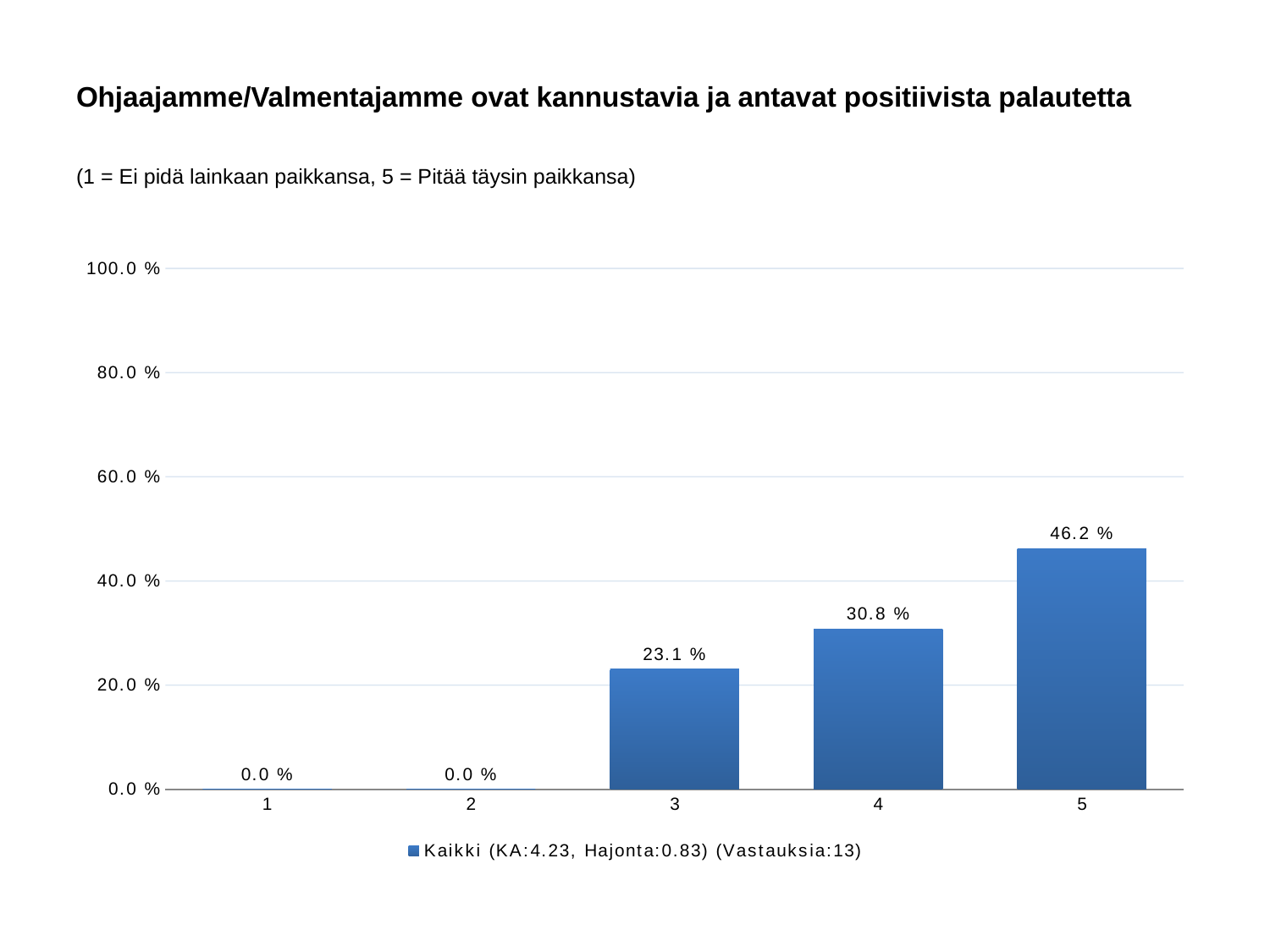
How many series does the legend list? 1 What is the difference between the values for category 5 and category 4? 15.4 % What is the value for category 4? 30.8 % What kind of chart is shown? bar chart What is the value for category 3? 23.1 % Do the values rise or fall from category 1 to category 5? rise Which category has the highest value? 5 Which is larger, the value for category 3 or category 4? 4 Is the value for category 5 greater or less than 40.0 %? greater What is the value for category 1? 0.0 % How many categories are shown on the x axis? 5 What is the value for category 5? 46.2 %